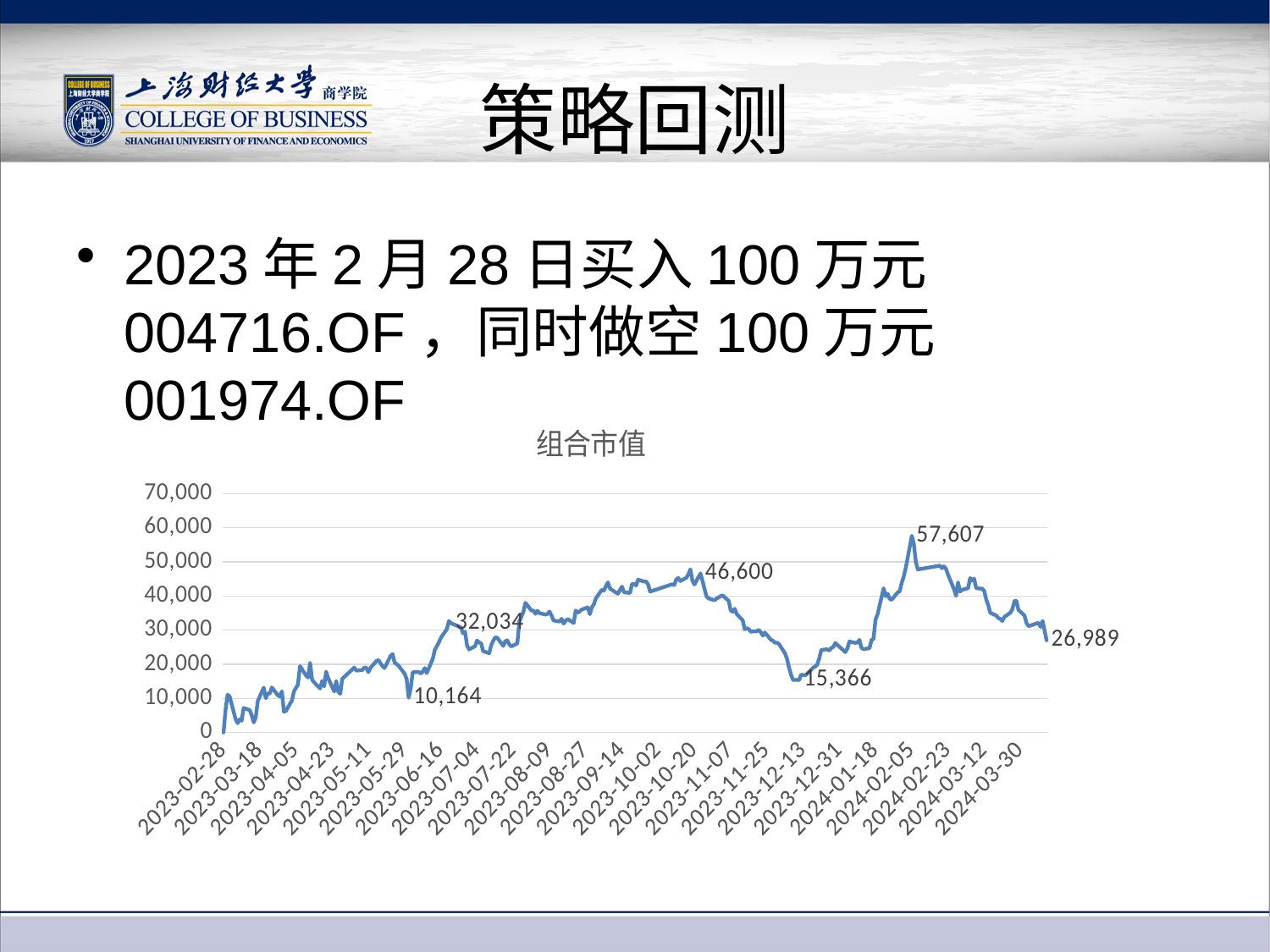
What is the value labeled at the trough near 2023-12-13? 15,366 What kind of chart is shown on the slide? line chart What is the difference between the labeled values 46,600 and 32,034? 14,568 What is the title of the chart? 组合市值 Does the line rise or fall from the start of the series to the labeled peak of 57,607? rise What is the lowest value labeled on the chart? 10,164 What is the difference between the labeled peak value 57,607 and the final labeled value 26,989? 30,618 Which labeled value is larger, 57,607 or 46,600? 57,607 What is the value labeled at the end of the line, near 2024-03-30? 26,989 What is the highest value labeled on the chart? 57,607 Is the value at the start of the line, at 2023-02-28, greater or less than 10,000? less How many data labels are printed on the line? 6